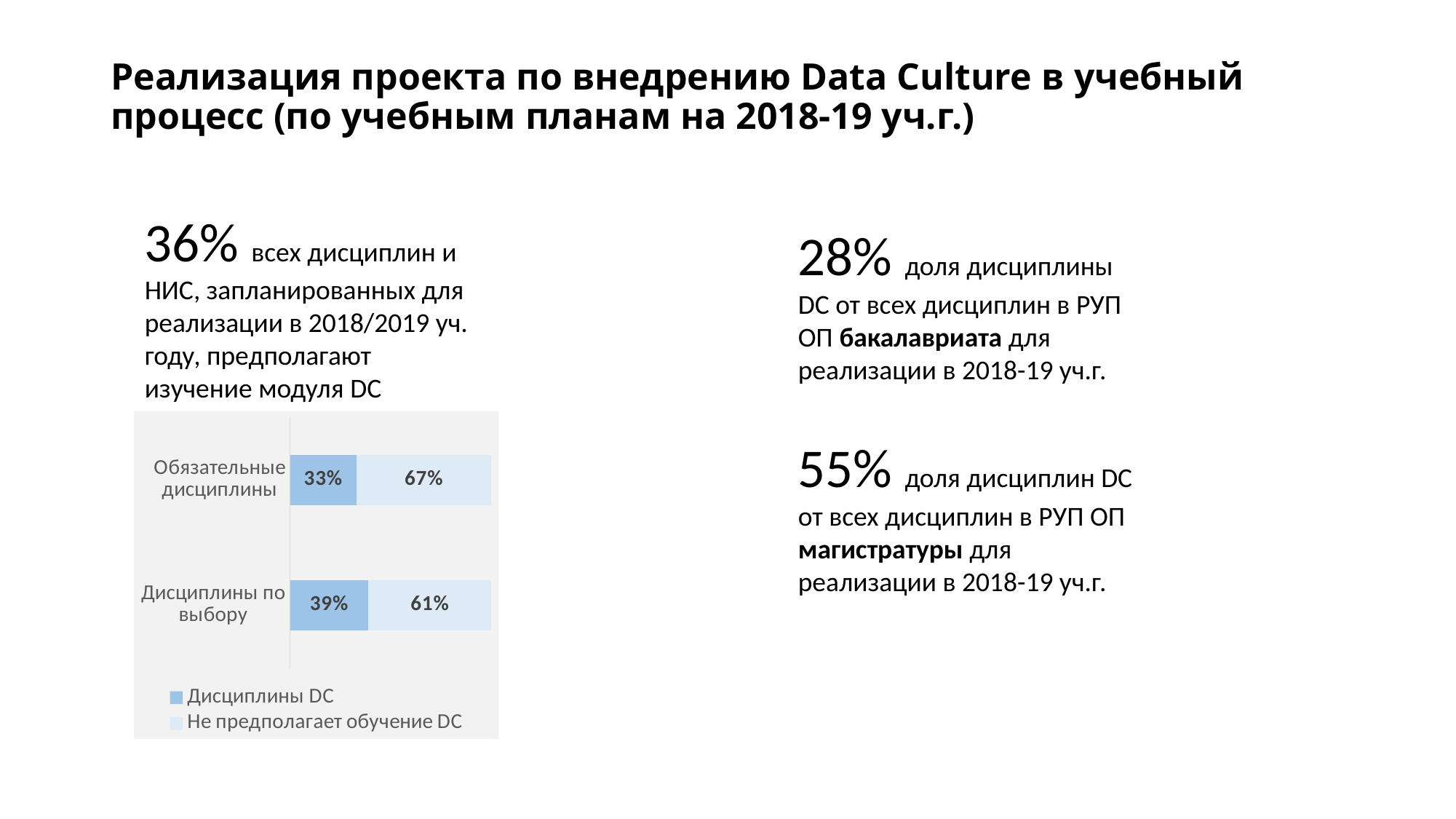
Is the "Дисциплины DC" value for "Обязательные дисциплины" larger or smaller than the "Не предполагает обучение DC" value for the same category? Smaller What is the value of "Дисциплины DC" for "Дисциплины по выбору"? 39% What kind of chart is shown on the slide? Stacked bar chart Which category has the lower share of "Не предполагает обучение DC"? Дисциплины по выбору What is the value of "Не предполагает обучение DC" for "Дисциплины по выбору"? 61% What is the value of "Не предполагает обучение DC" for "Обязательные дисциплины"? 67% How many categories are shown in the chart? 2 How many series does the legend list? 2 What is the total of the stacked bar for "Обязательные дисциплины"? 100% What is the difference between the "Дисциплины DC" values for "Дисциплины по выбору" and "Обязательные дисциплины"? 6% Which category has the higher share of "Дисциплины DC"? Дисциплины по выбору What is the value of "Дисциплины DC" for "Обязательные дисциплины"? 33%